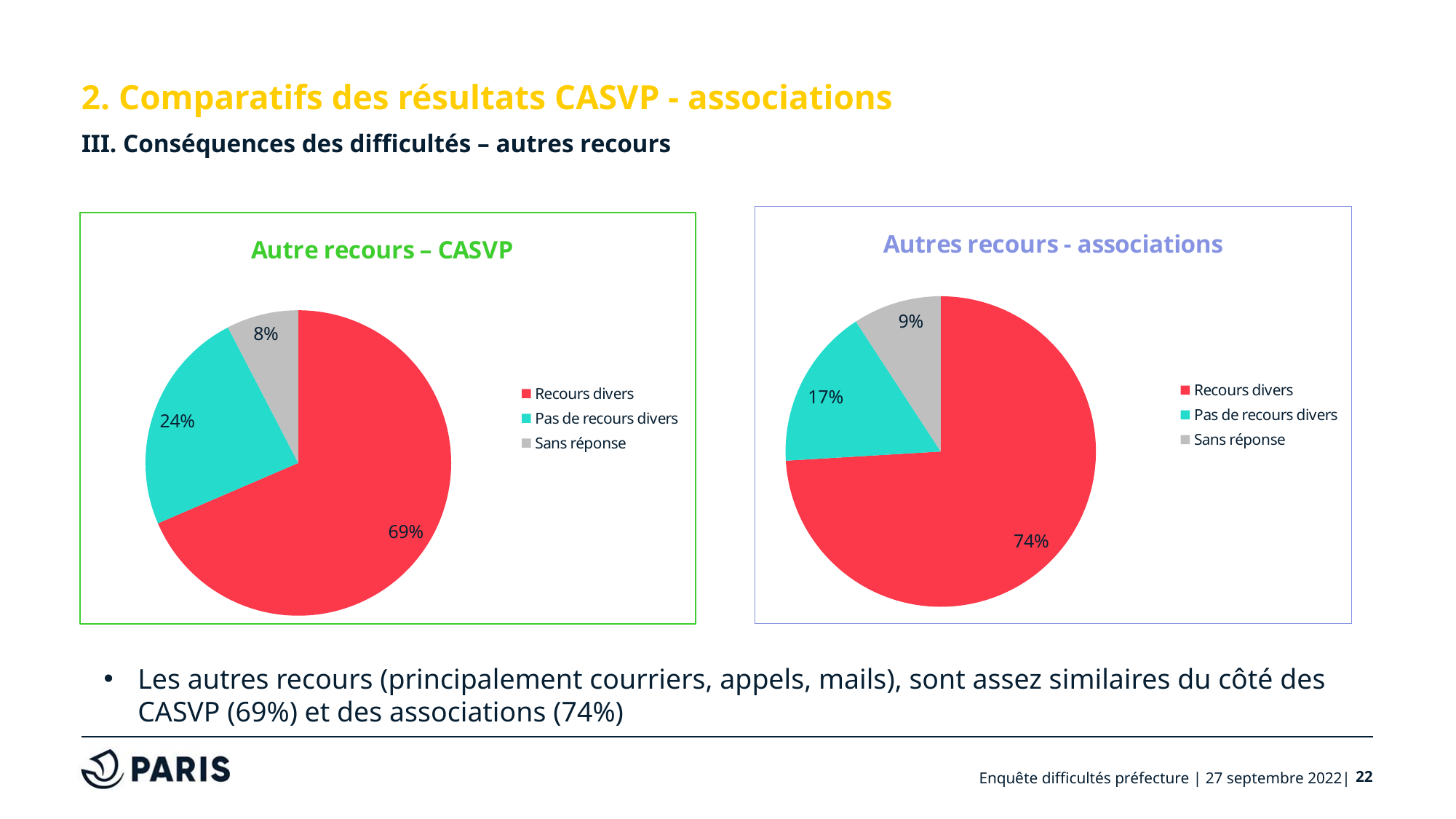
In the 'Autre recours – CASVP' chart, what share is 'Sans réponse'? 8% What is the difference between the 'Recours divers' share in the 'Autres recours - associations' chart and in the 'Autre recours – CASVP' chart? 5% In the 'Autre recours – CASVP' chart, what share is 'Pas de recours divers'? 24% In the 'Autre recours – CASVP' chart, what share is 'Recours divers'? 69% What type of chart is the 'Autre recours – CASVP' chart? Pie chart In the 'Autres recours - associations' chart, which category has the smallest slice? Sans réponse How many categories does the legend of the 'Autres recours - associations' chart list? 3 In the 'Autres recours - associations' chart, what share is 'Recours divers'? 74% In the 'Autres recours - associations' chart, what share is 'Pas de recours divers'? 17% In the 'Autres recours - associations' chart, what share is 'Sans réponse'? 9% In the 'Autre recours – CASVP' chart, which category has the largest slice? Recours divers Which chart has the larger 'Pas de recours divers' share, 'Autre recours – CASVP' or 'Autres recours - associations'? Autre recours – CASVP